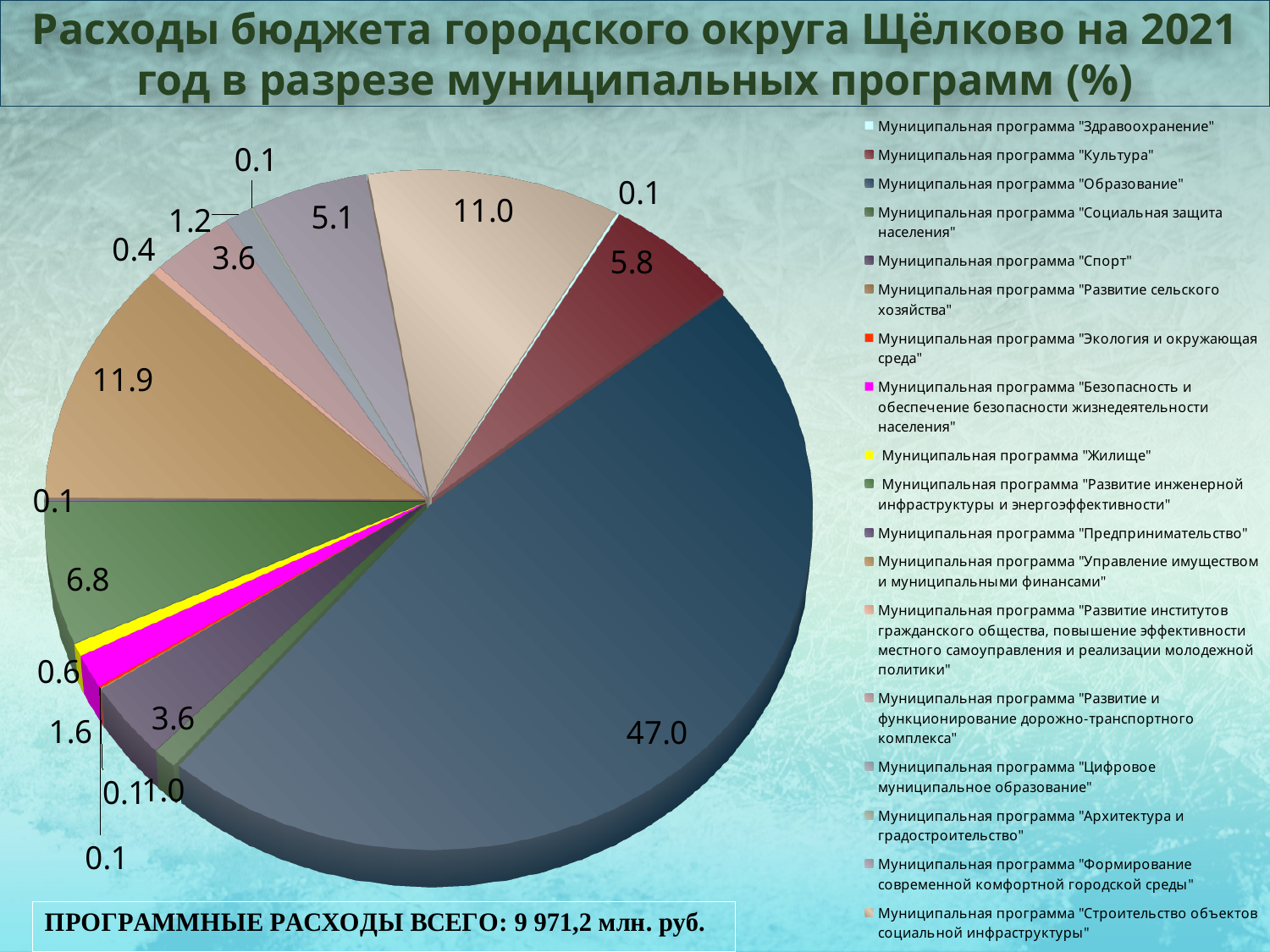
What percentage of the budget goes to the programme "Управление имуществом и муниципальными финансами"? 11.9 Which municipal programme has the largest share of the 2021 budget expenditure? Муниципальная программа "Образование" What percentage of the budget goes to the programme "Развитие инженерной инфраструктуры и энергоэффективности"? 6.8 Which year's budget expenditure does the chart title refer to? 2021 Which slice is larger: "Безопасность и обеспечение безопасности жизнедеятельности населения" (magenta) or "Жилище" (yellow)? Безопасность и обеспечение безопасности жизнедеятельности населения What kind of chart is shown on the slide? pie chart What percentage of the budget goes to the programme "Образование"? 47.0 What is the difference in percentage points between the "Образование" slice and the "Здравоохранение" slice? 46.9 What percentage of the budget goes to the programme "Культура"? 5.8 What percentage of the budget goes to the programme "Здравоохранение"? 0.1 What is the total programme expenditure stated at the bottom of the slide? 9 971,2 млн. руб. How many municipal programmes does the legend list? 18